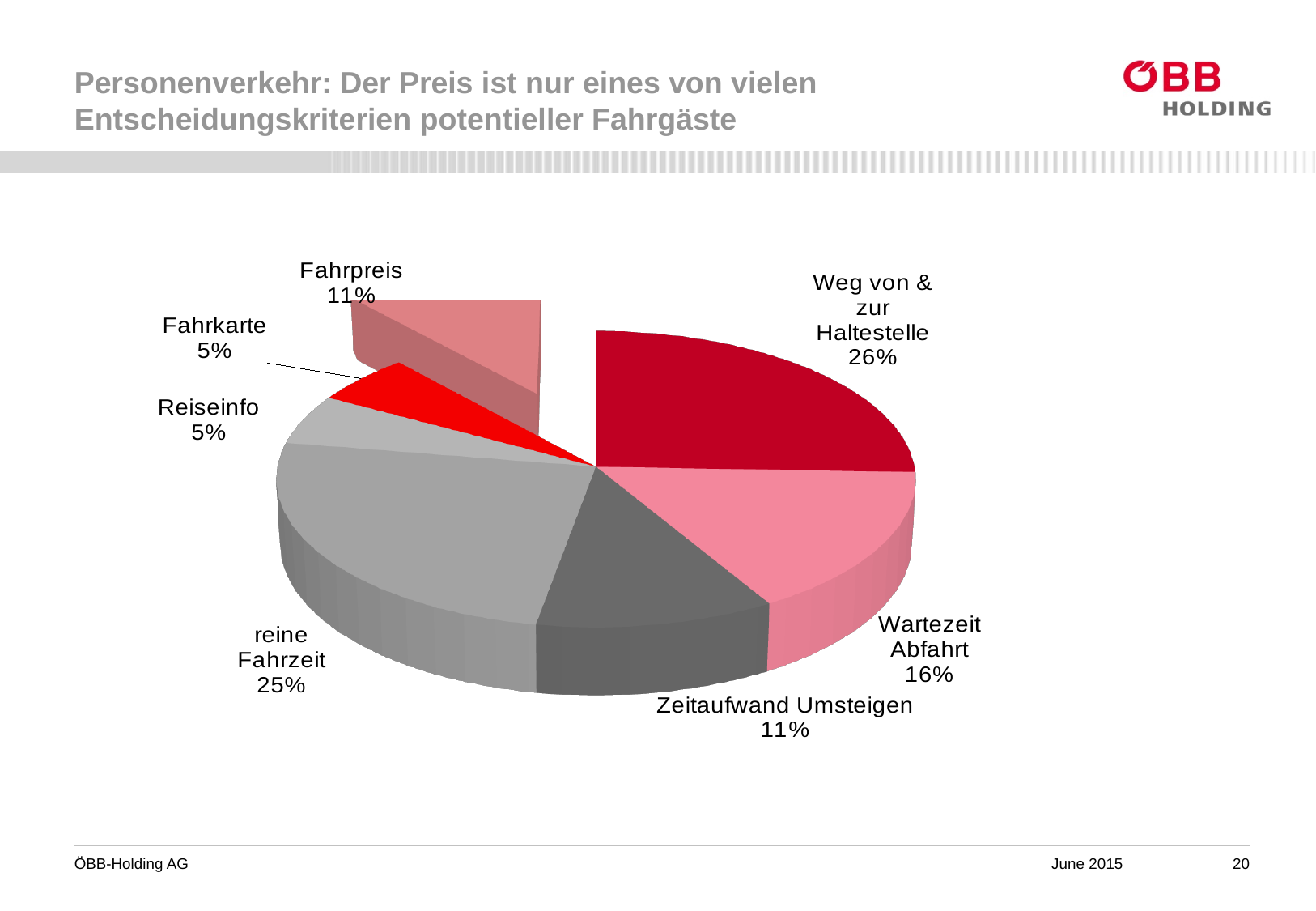
What is the difference in percentage points between "Weg von & zur Haltestelle" and "Wartezeit Abfahrt"? 10 percentage points What is the value shown for "Fahrpreis"? 11% What is the value shown for "Wartezeit Abfahrt"? 16% Which slice is pulled out (exploded) from the rest of the pie? Fahrpreis What is the value shown for "reine Fahrzeit"? 25% What kind of chart is shown on the slide? pie chart Which category has the largest slice of the pie? Weg von & zur Haltestelle How many categories (slices) does the pie chart have? 7 What is the difference in percentage points between "Fahrpreis" and "Fahrkarte"? 6 percentage points What share of the pie does "Weg von & zur Haltestelle" have? 26% Which is larger, the slice for "reine Fahrzeit" or the slice for "Zeitaufwand Umsteigen"? reine Fahrzeit What is the value shown for "Reiseinfo"? 5%